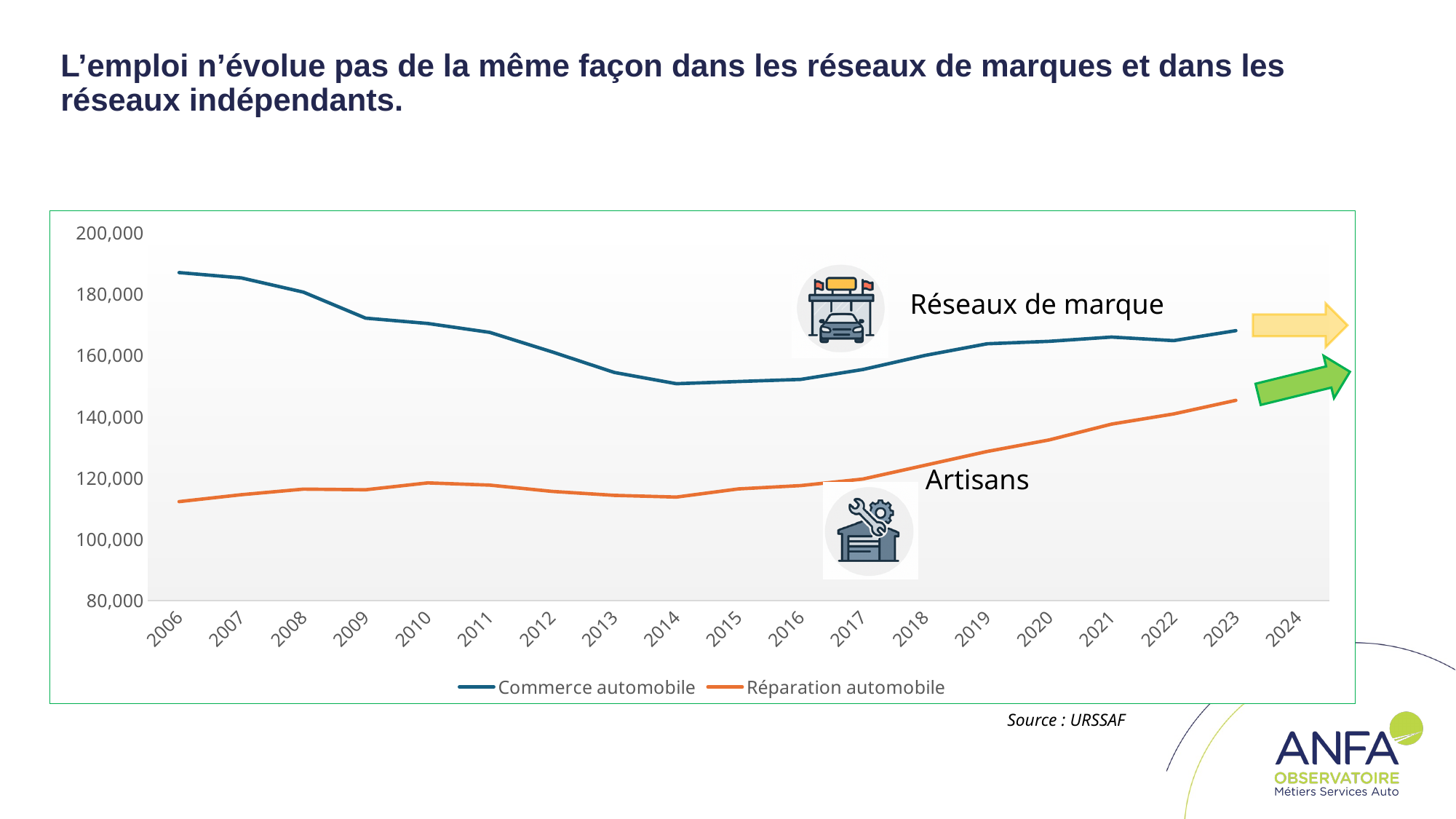
How many series does the legend list? 2 In which year does the Commerce automobile series reach its highest value? 2006 What kind of chart is shown on the slide? line chart Which series has the higher value in 2006, Commerce automobile or Réparation automobile? Commerce automobile What are the two series named in the legend? Commerce automobile and Réparation automobile Is the value for Commerce automobile in 2006 greater or less than 180,000? greater Is the value for Réparation automobile in 2006 greater or less than 120,000? less Is the value for Réparation automobile in 2023 greater or less than 140,000? greater Does the Réparation automobile series rise or fall between 2014 and 2023? rise In which year does the Commerce automobile series reach its lowest value? 2014 In which year does the Réparation automobile series reach its highest value? 2023